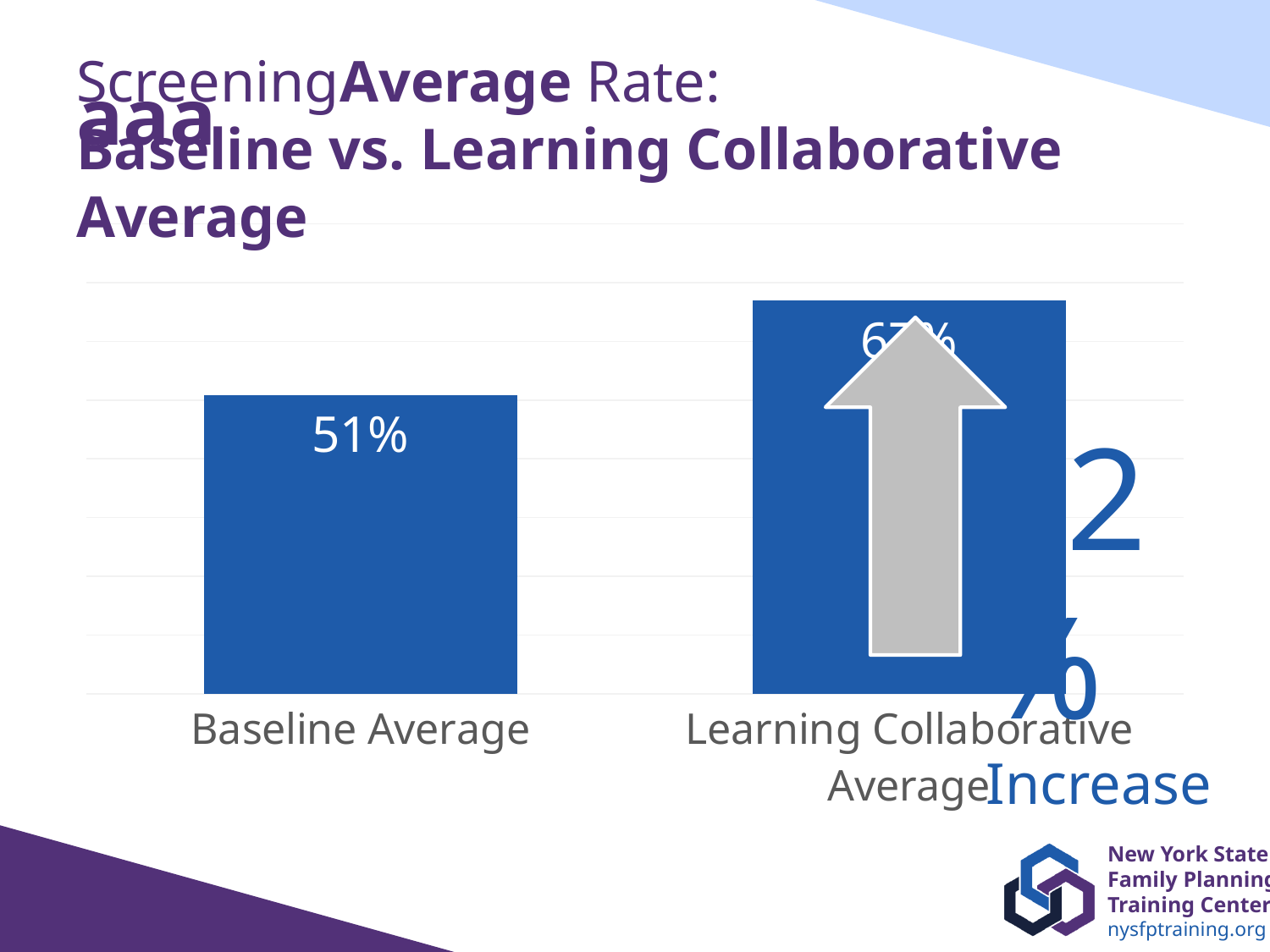
Which is larger, the Baseline Average or the Learning Collaborative Average? Learning Collaborative Average How many categories are plotted in the chart? 2 What is the label of the left-hand bar? Baseline Average What colour are the bars in the chart? Blue Which category has the lowest bar? Baseline Average Do the values rise or fall from Baseline Average to Learning Collaborative Average? Rise What is the value shown for Baseline Average? 51% What kind of chart is shown on the slide? Bar chart Which category has the highest bar? Learning Collaborative Average